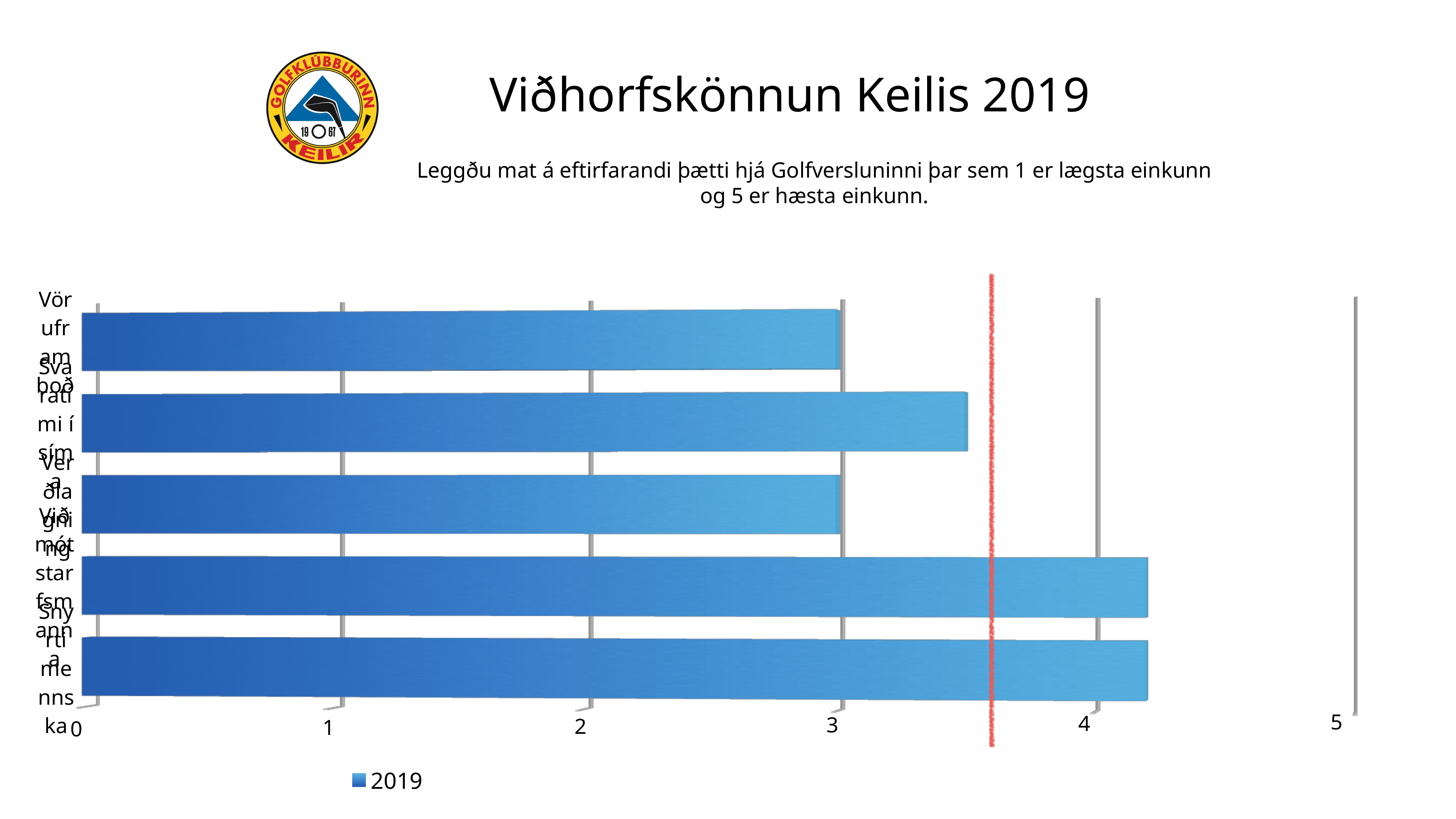
How many series does the legend list? 1 How many bars does the chart have? 5 What is the legend entry for the series in the chart? 2019 What is the title of the slide containing the chart? Viðhorfskönnun Keilis 2019 Is the value for the second bar from the top greater or less than 4? less What kind of chart is shown on the slide? bar chart Is the value for the top bar greater or less than 2? greater Is the value for the top bar greater or less than 4? less Which is larger, the value for the top bar or the value for the second bar from the top? the second bar from the top Which is larger, the value for the third bar from the top or the value for the fourth bar from the top? the fourth bar from the top